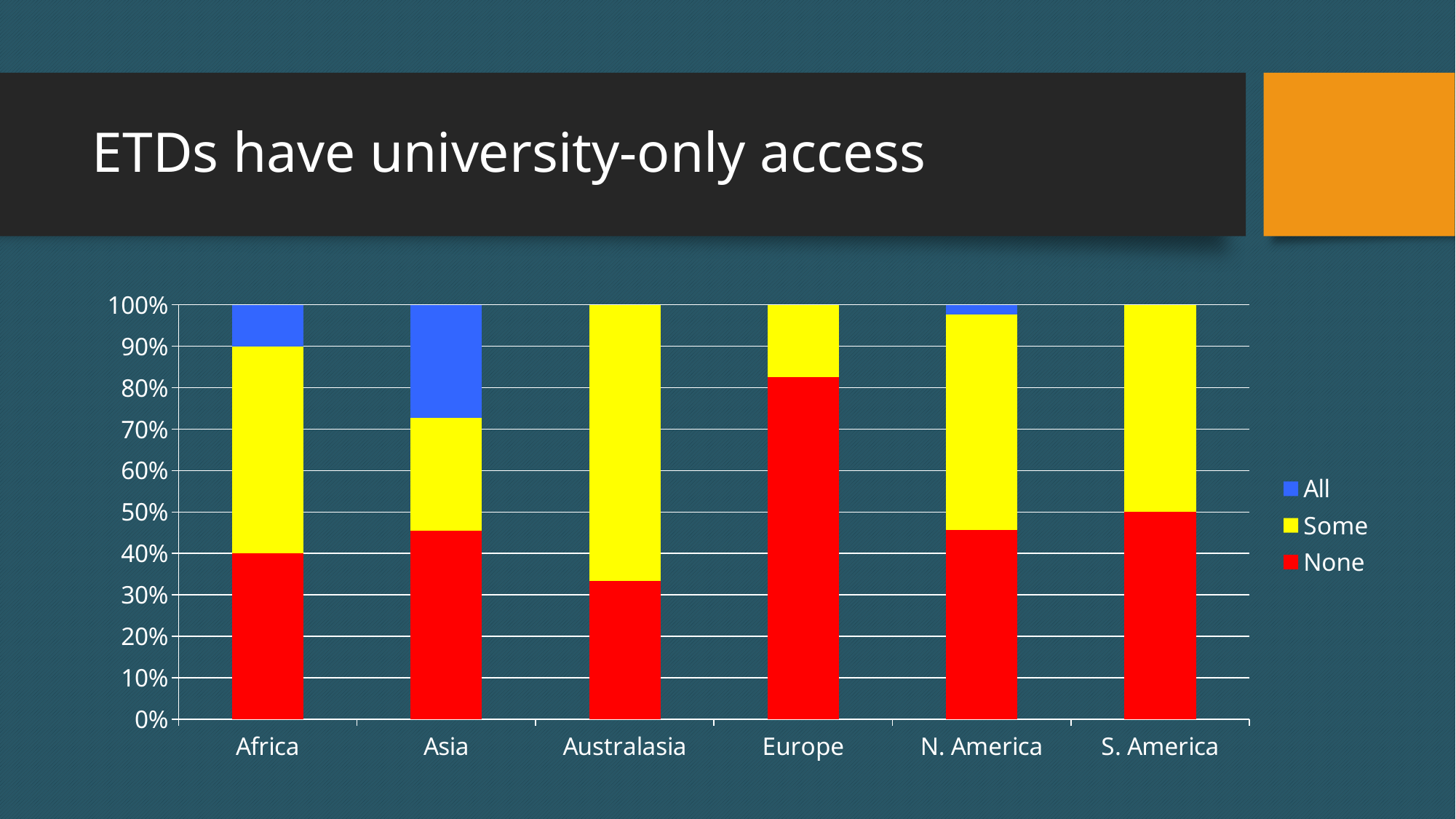
Which region has the smallest 'None' share? Australasia Which colour represents the 'None' series in the legend? Red How many regions are shown on the x axis of the chart? 6 Is the 'None' share for Australasia greater or less than 40%? less Is the 'All' share for Asia greater or less than 20%? greater Which is larger, the 'All' share for Asia or the 'All' share for Africa? Asia Which region has the largest 'All' share? Asia What kind of chart is shown on the slide? Stacked bar chart How many series does the chart's legend list? 3 Which region has the largest 'None' share? Europe What is the total of the stacked bar for Europe? 100% Is the 'None' share for Europe greater or less than 70%? greater